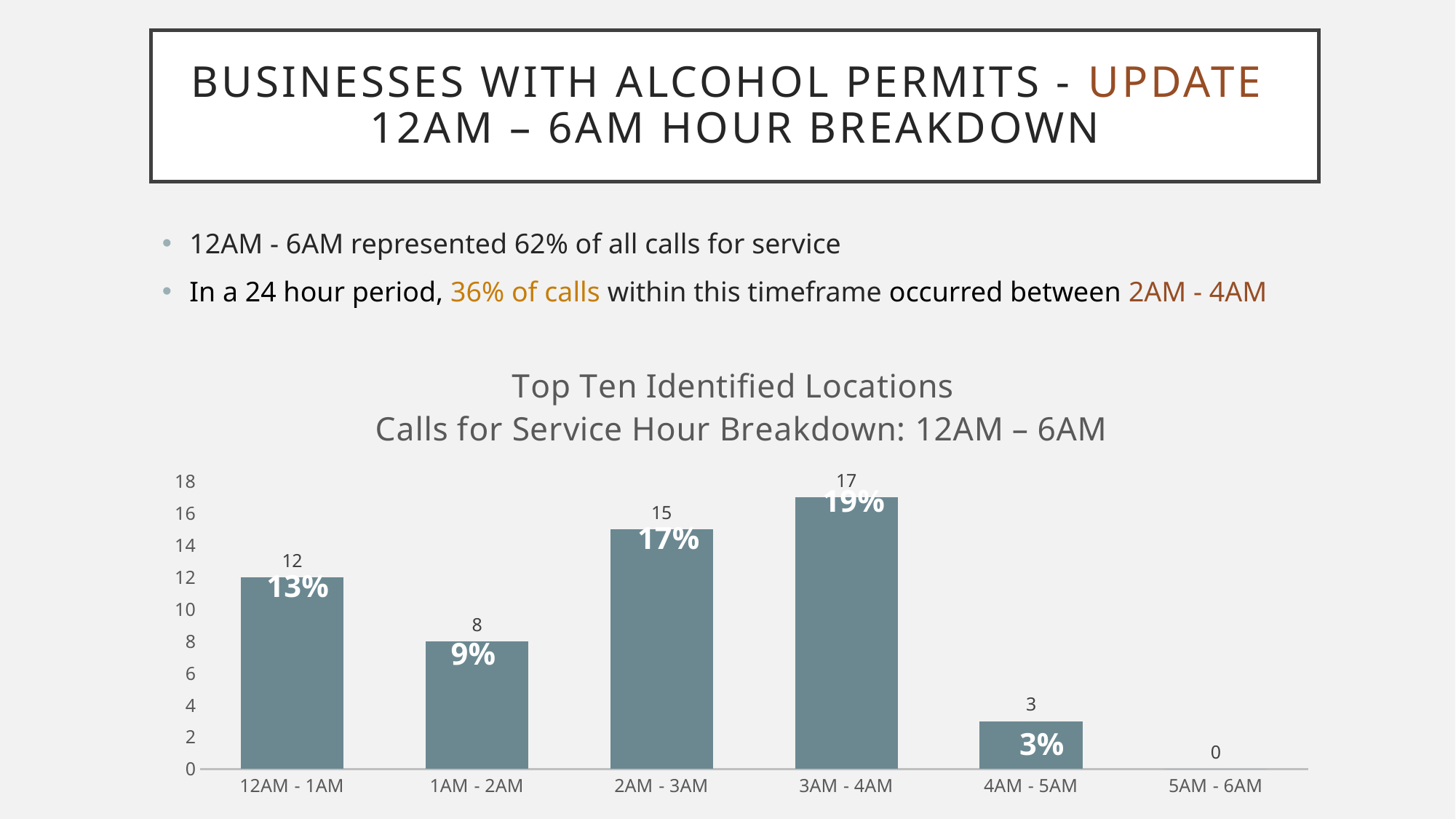
What is the total of the values across all six hour categories? 55 What is the title of the chart? Top Ten Identified Locations Calls for Service Hour Breakdown: 12AM – 6AM Which is larger, the value for 12AM - 1AM or the value for 2AM - 3AM? 2AM - 3AM What percentage label is shown on the 2AM - 3AM bar? 17% What is the value for 3AM - 4AM? 17 What is the value for 12AM - 1AM? 12 What is the difference between the values for 3AM - 4AM and 1AM - 2AM? 9 Which hour has the highest number of calls? 3AM - 4AM How many hour categories are shown on the x axis? 6 What kind of chart is shown on the slide? Bar chart What is the value for 4AM - 5AM? 3 Which hour has the lowest number of calls? 5AM - 6AM